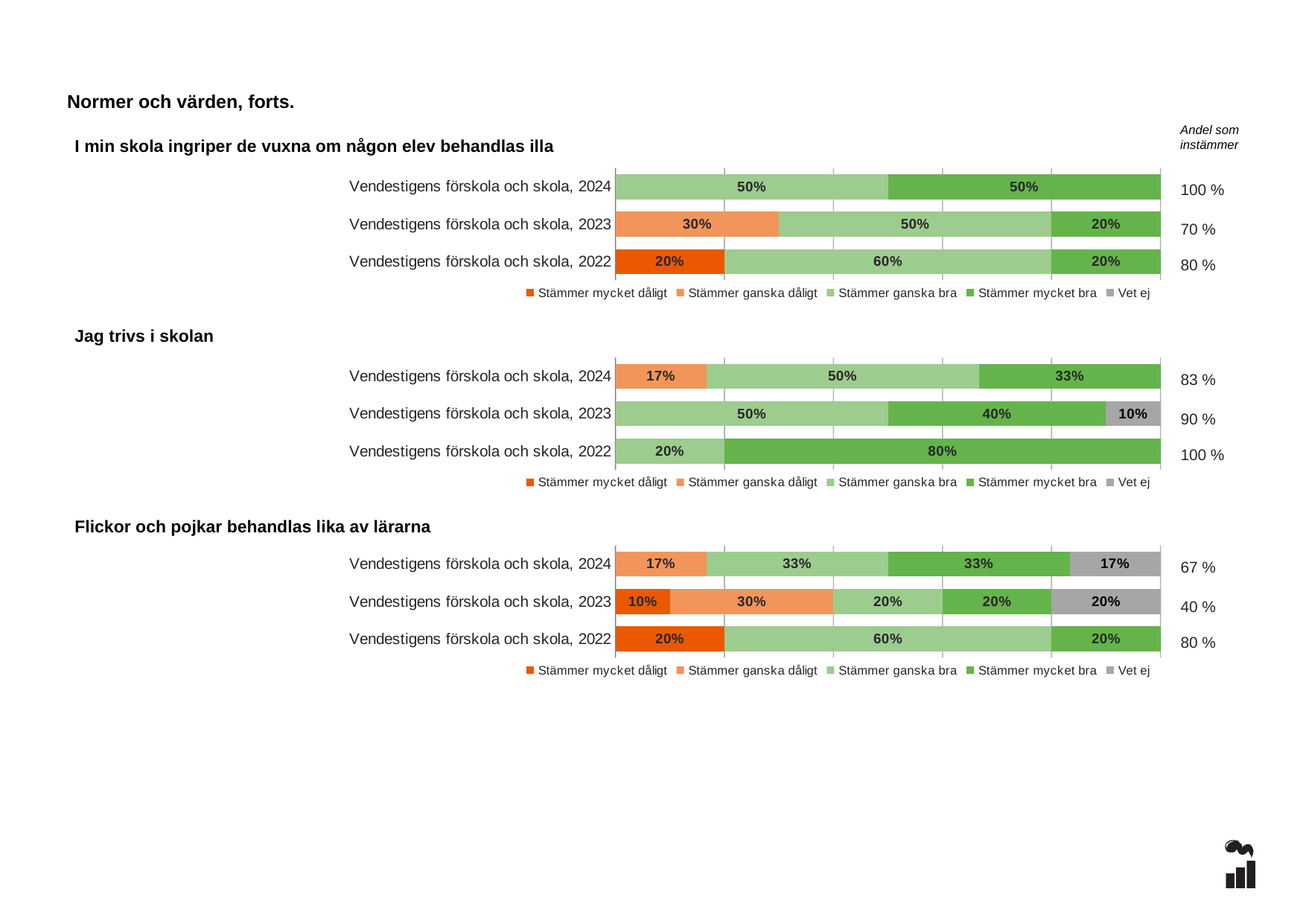
In the chart 'I min skola ingriper de vuxna om någon elev behandlas illa', which year has the lowest 'Andel som instämmer'? 2023 In the chart 'Flickor och pojkar behandlas lika av lärarna', is the 'Stämmer ganska bra' value larger for 2022 or 2023? 2022 How many bars are shown in the chart 'Flickor och pojkar behandlas lika av lärarna'? 3 In the chart 'Flickor och pojkar behandlas lika av lärarna', which year has the highest 'Andel som instämmer'? 2022 What kind of chart is 'I min skola ingriper de vuxna om någon elev behandlas illa'? Stacked bar chart In the chart 'Jag trivs i skolan', what is the value for 'Stämmer mycket bra' for Vendestigens förskola och skola, 2022? 80% In the chart 'Flickor och pojkar behandlas lika av lärarna', what is the value for 'Stämmer mycket dåligt' for Vendestigens förskola och skola, 2023? 10% In the chart 'I min skola ingriper de vuxna om någon elev behandlas illa', what is the value for 'Stämmer ganska dåligt' for Vendestigens förskola och skola, 2023? 30% In the chart 'I min skola ingriper de vuxna om någon elev behandlas illa', what is the 'Andel som instämmer' for Vendestigens förskola och skola, 2024? 100 % In the chart 'Jag trivs i skolan', what is the difference between the 'Stämmer mycket bra' values for 2022 and 2024? 47 percentage points How many series does the legend of the chart 'Jag trivs i skolan' list? 5 In the chart 'Jag trivs i skolan', what is the value for 'Vet ej' for Vendestigens förskola och skola, 2023? 10%